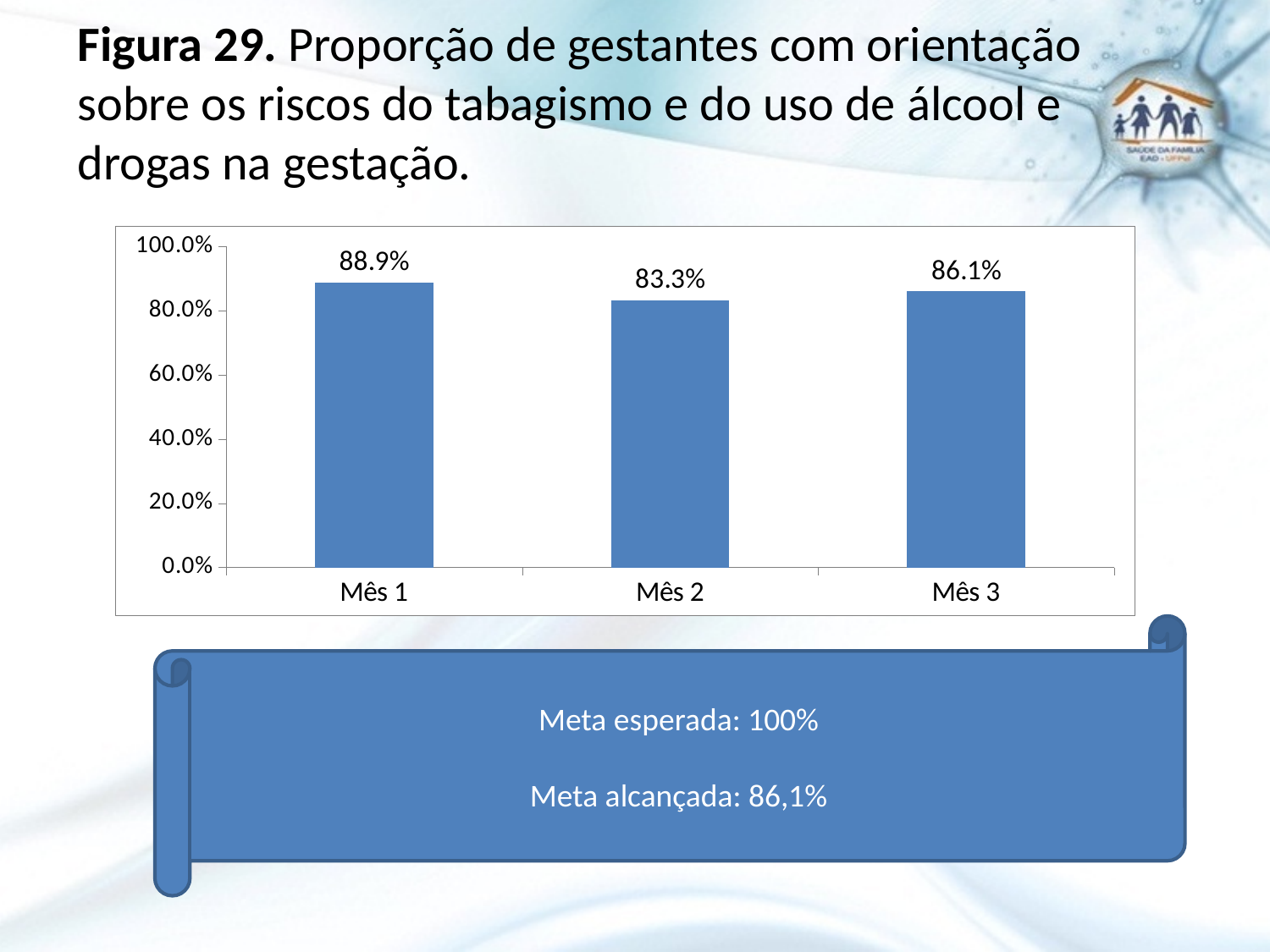
What kind of chart is shown on the slide? bar chart What is the highest value shown on the y axis? 100.0% What is the difference between the values for Mês 1 and Mês 2? 5.6% Which month has the lowest value? Mês 2 What is the value for Mês 1? 88.9% How many months are shown on the x axis? 3 What is the value for Mês 3? 86.1% What is the difference between the values for Mês 3 and Mês 2? 2.8% Is the value for Mês 2 greater or less than 80.0%? greater What is the value for Mês 2? 83.3% Which month has the highest value? Mês 1 Which is larger, the value for Mês 1 or the value for Mês 3? Mês 1